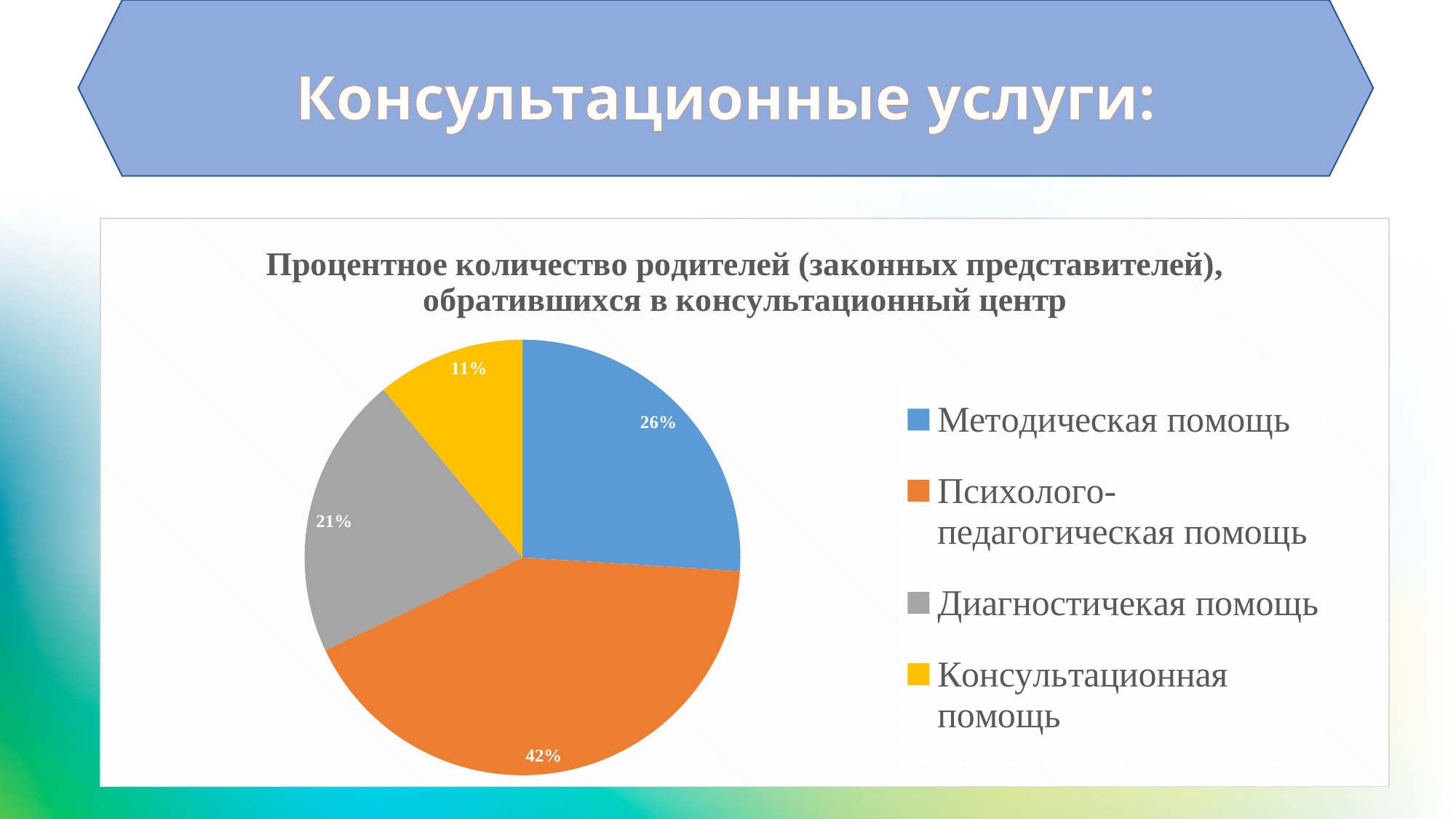
How many categories are shown in the pie chart? 4 Which category has the smallest slice of the pie? Консультационная помощь Which is larger: the slice for Методическая помощь or the slice for Диагностичекая помощь? Методическая помощь What share of the pie does Психолого-педагогическая помощь represent? 42% What is the title of the chart? Процентное количество родителей (законных представителей), обратившихся в консультационный центр Which category has the largest slice of the pie? Психолого-педагогическая помощь What kind of chart is shown on the slide? Pie chart What is the difference in percentage points between Психолого-педагогическая помощь and Методическая помощь? 16% What colour is the slice for Консультационная помощь? Yellow What share of the pie does Диагностичекая помощь represent? 21% What share of the pie does Методическая помощь represent? 26%